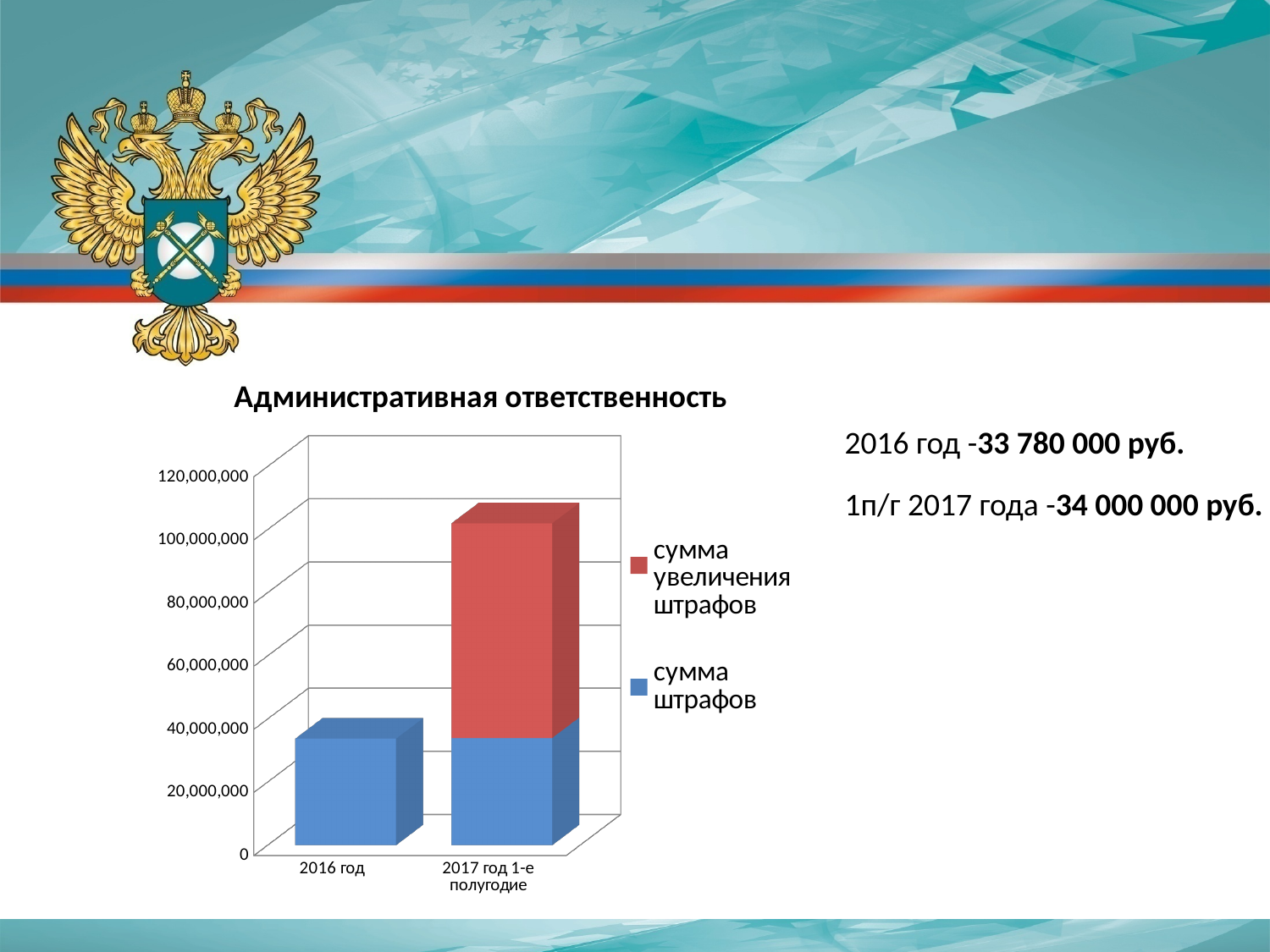
Which series is shown in red in the chart? сумма увеличения штрафов Is the total bar for 2016 год greater or less than 20,000,000? greater What is the title of the chart? Административная ответственность How many series does the chart legend list? 2 Which category has the tallest stacked bar in the chart? 2017 год 1-е полугодие Is the total stacked bar for 2017 год 1-е полугодие greater or less than 80,000,000? greater How many categories are shown on the x axis of the chart? 2 Do the total bar heights rise or fall from 2016 год to 2017 год 1-е полугодие? rise What kind of chart is shown on the slide? bar chart Is the total bar for 2016 год greater or less than 40,000,000? less Which category has the shortest stacked bar in the chart? 2016 год Which is larger: the total bar for 2016 год or the total bar for 2017 год 1-е полугодие? 2017 год 1-е полугодие